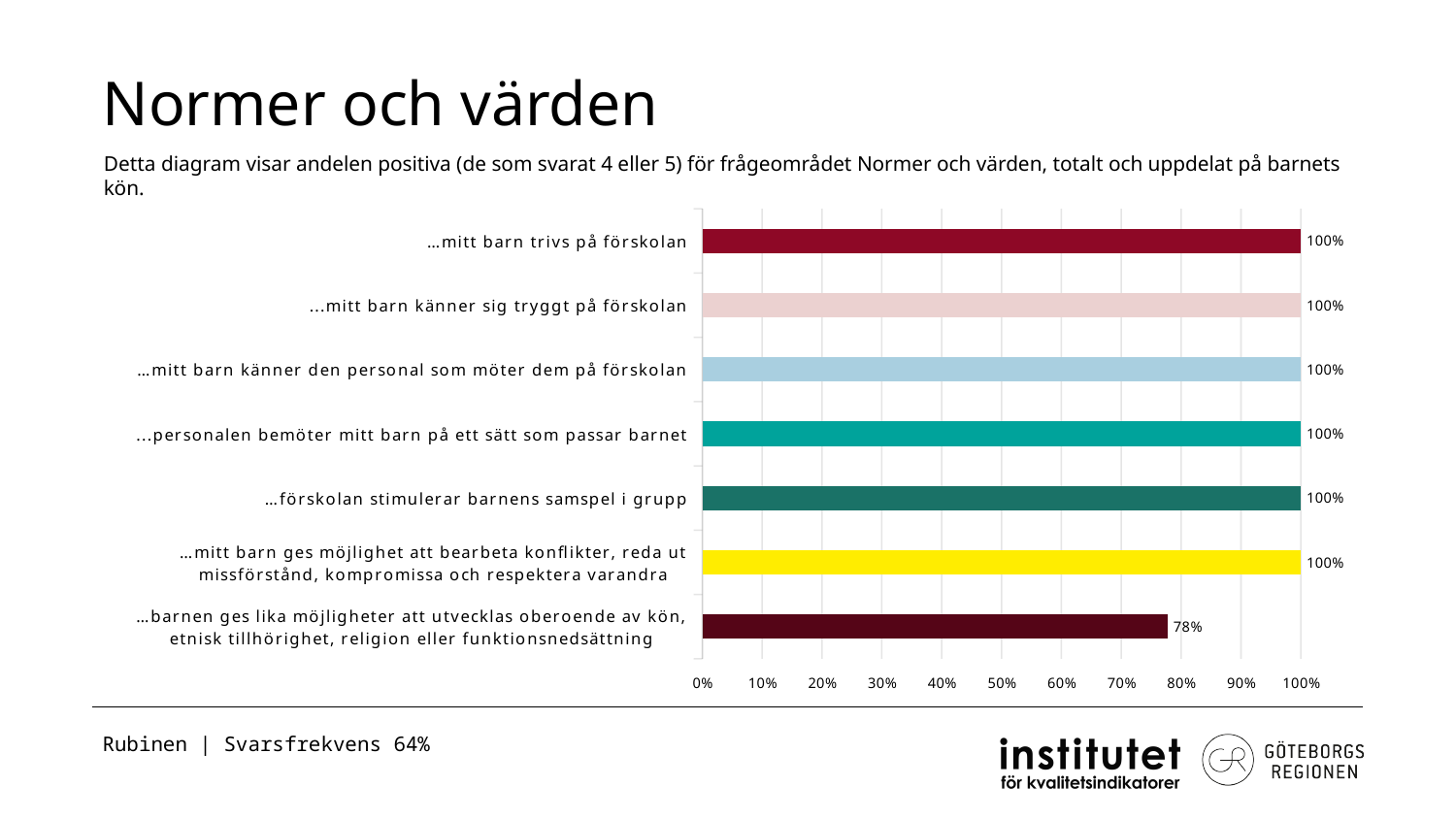
What is the difference between the value for "…mitt barn ges möjlighet att bearbeta konflikter, reda ut missförstånd, kompromissa och respektera varandra" and the value for "…barnen ges lika möjligheter att utvecklas oberoende av kön, etnisk tillhörighet, religion eller funktionsnedsättning"? 22% What is the value for "…barnen ges lika möjligheter att utvecklas oberoende av kön, etnisk tillhörighet, religion eller funktionsnedsättning"? 78% How many categories have a value of 100%? 6 What is the value for "…mitt barn trivs på förskolan"? 100% Is the value for "…barnen ges lika möjligheter att utvecklas oberoende av kön, etnisk tillhörighet, religion eller funktionsnedsättning" greater or less than 80%? less Which category has the lowest value? …barnen ges lika möjligheter att utvecklas oberoende av kön, etnisk tillhörighet, religion eller funktionsnedsättning What is the highest value shown on the x axis of the chart? 100% What is the title of the slide containing the chart? Normer och värden Which is larger: the value for "…personalen bemöter mitt barn på ett sätt som passar barnet" or the value for "…barnen ges lika möjligheter att utvecklas oberoende av kön, etnisk tillhörighet, religion eller funktionsnedsättning"? …personalen bemöter mitt barn på ett sätt som passar barnet What kind of chart is shown on the slide? bar chart How many categories (bars) does the chart show? 7 What is the value for "…förskolan stimulerar barnens samspel i grupp"? 100%